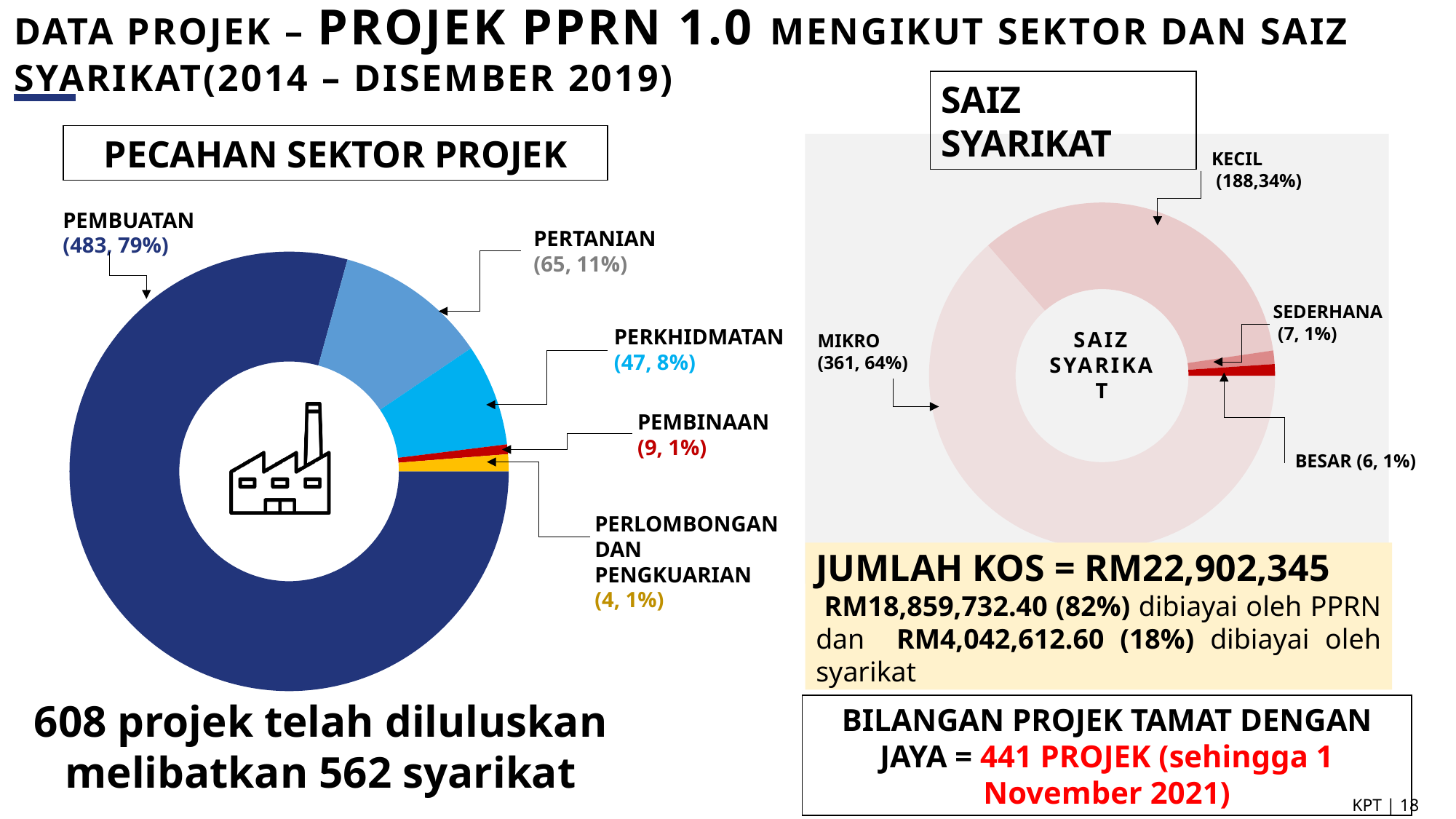
In the SAIZ SYARIKAT chart, how many company size categories are shown? 4 In the SAIZ SYARIKAT chart, what percentage share does KECIL have? 34% In the SAIZ SYARIKAT chart, which is larger, SEDERHANA or BESAR? SEDERHANA In the PECAHAN SEKTOR PROJEK chart, what percentage share does PERTANIAN have? 11% In the PECAHAN SEKTOR PROJEK chart, which sector has the smallest number of projects? PERLOMBONGAN DAN PENGKUARIAN In the SAIZ SYARIKAT chart, how many companies are MIKRO? 361 What type of chart is the PECAHAN SEKTOR PROJEK chart? Donut (pie) chart In the PECAHAN SEKTOR PROJEK chart, what is the difference in project count between PERTANIAN and PERKHIDMATAN? 18 In the SAIZ SYARIKAT chart, which company size has the largest count? MIKRO In the PECAHAN SEKTOR PROJEK chart, which sector has the largest number of projects? PEMBUATAN In the PECAHAN SEKTOR PROJEK chart, how many sectors are shown? 5 In the PECAHAN SEKTOR PROJEK chart, how many projects are in the PEMBUATAN sector? 483